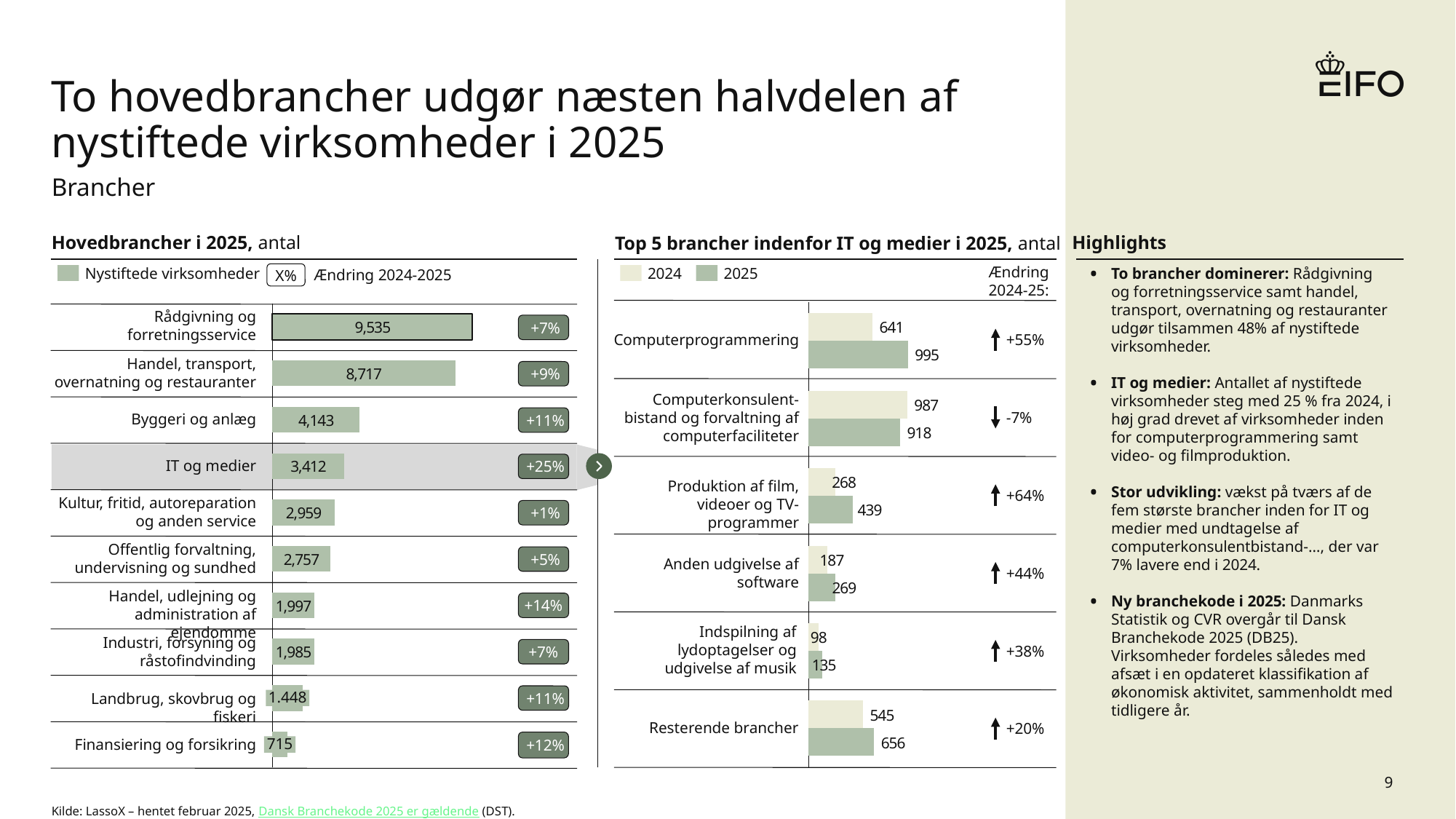
What kind of chart is 'Top 5 brancher indenfor IT og medier i 2025, antal'? Bar chart In the chart 'Top 5 brancher indenfor IT og medier i 2025, antal', which category shows a negative change 2024-25? Computerkonsulentbistand og forvaltning af computerfaciliteter In the chart 'Hovedbrancher i 2025, antal', which is larger: the value for Byggeri og anlæg or the value for IT og medier? Byggeri og anlæg In the chart 'Top 5 brancher indenfor IT og medier i 2025, antal', how many series does the legend list? 2 In the chart 'Top 5 brancher indenfor IT og medier i 2025, antal', what is the 2025 value for Computerprogrammering? 995 In the chart 'Hovedbrancher i 2025, antal', what is the change 2024-2025 shown for IT og medier? +25% In the chart 'Hovedbrancher i 2025, antal', what is the difference between the values for Rådgivning og forretningsservice and Handel, transport, overnatning og restauranter? 818 In the chart 'Top 5 brancher indenfor IT og medier i 2025, antal', what is the 2024 value for Produktion af film, videoer og TV-programmer? 268 In the chart 'Top 5 brancher indenfor IT og medier i 2025, antal', what is the difference between the 2025 and 2024 values for Anden udgivelse af software? 82 In the chart 'Hovedbrancher i 2025, antal', how many newly founded companies are shown for Rådgivning og forretningsservice? 9,535 In the chart 'Hovedbrancher i 2025, antal', how many categories are shown? 10 In the chart 'Hovedbrancher i 2025, antal', which category has the lowest number of newly founded companies? Finansiering og forsikring